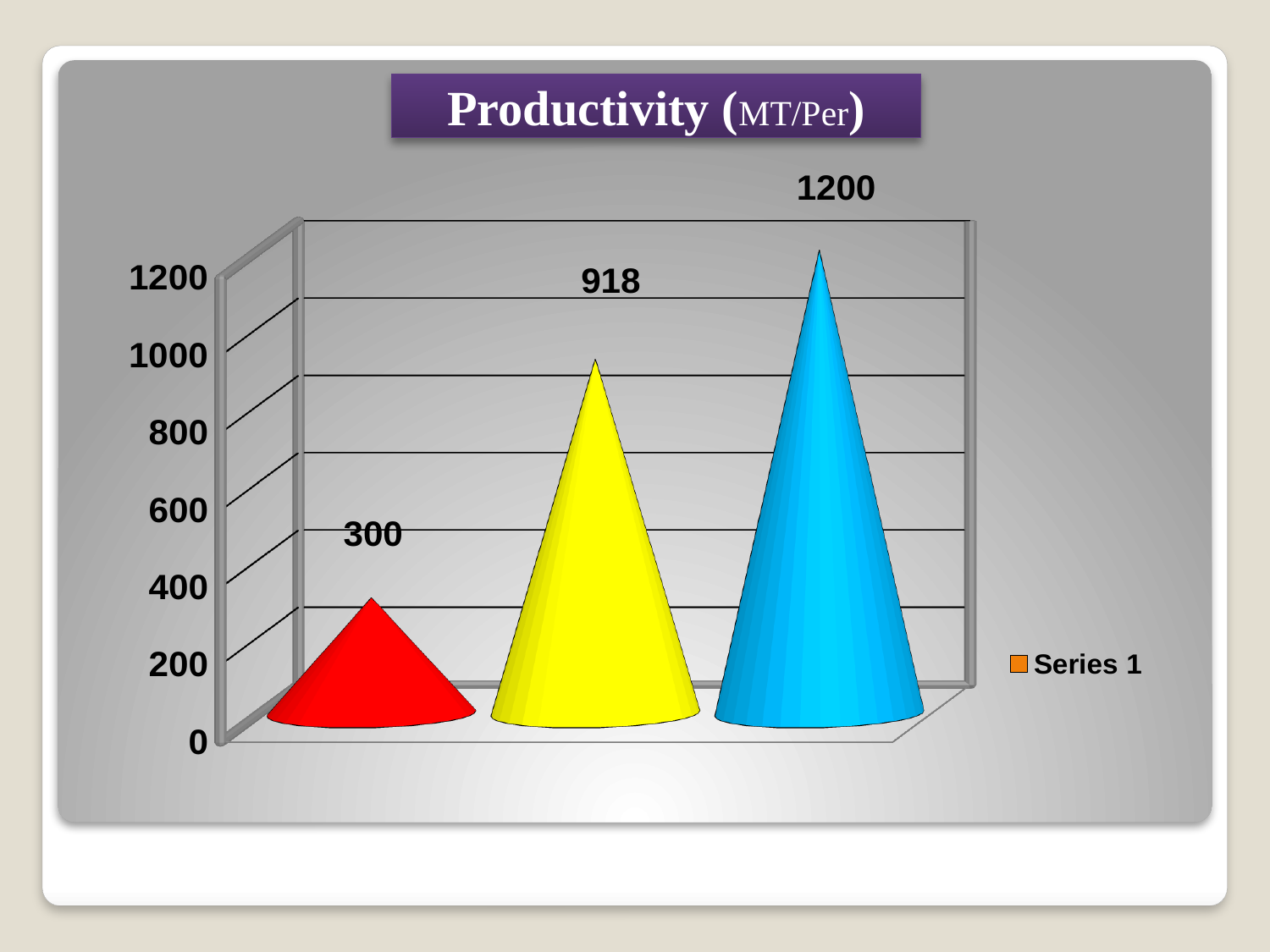
What is the title of the chart? Productivity (MT/Per) What is the value shown on the blue cone? 1200 What is the difference between the yellow cone's value and the red cone's value? 618 How many cones (data points) are plotted in the chart? 3 Do the values rise or fall from left to right across the chart? Rise What is the value shown on the yellow cone? 918 How many series does the legend list? 1 What is the difference between the blue cone's value and the red cone's value? 900 Which cone has the highest value? The blue cone (1200) Which cone has the lowest value? The red cone (300) What is the value shown on the red cone? 300 Which is larger, the yellow cone's value or the blue cone's value? The blue cone's value